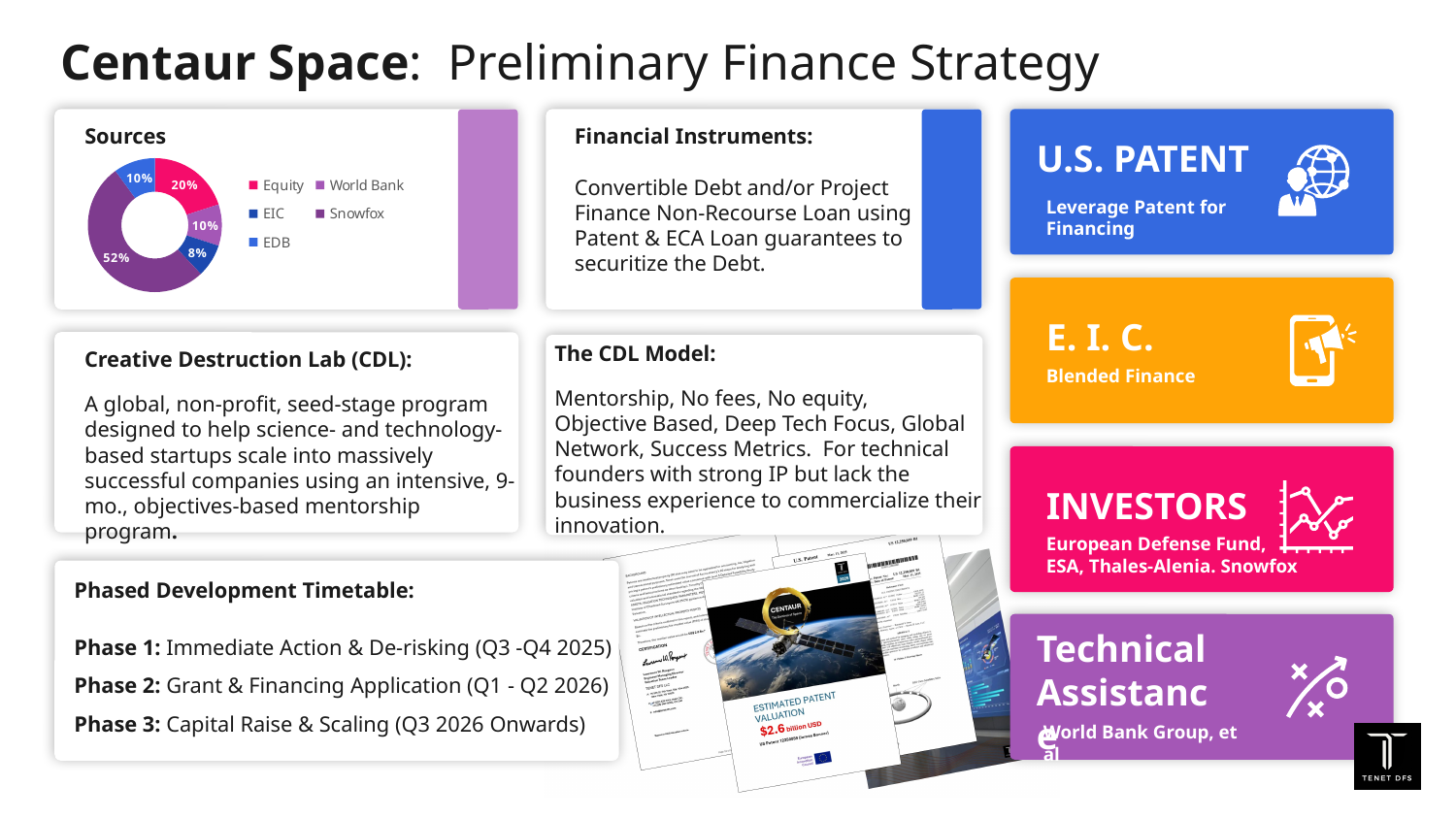
In the Sources chart, what percentage is attributed to Equity? 20% In the Sources chart, what share does Snowfox account for? 52% What type of chart is shown under "Sources"? Pie chart (donut) What is the title of the pie chart on the slide? Sources In the Sources chart, which is larger: the Equity share or the EIC share? Equity Which source has the largest share in the Sources chart? Snowfox In the Sources chart, what is the combined share of Equity and Snowfox? 72% In the Sources chart, what percentage is attributed to EIC? 8% Which source has the smallest share in the Sources chart? EIC How many sources are listed in the legend of the Sources chart? 5 In the Sources chart, what percentage is attributed to World Bank? 10% In the Sources chart, what is the difference between the Snowfox share and the Equity share? 32 percentage points